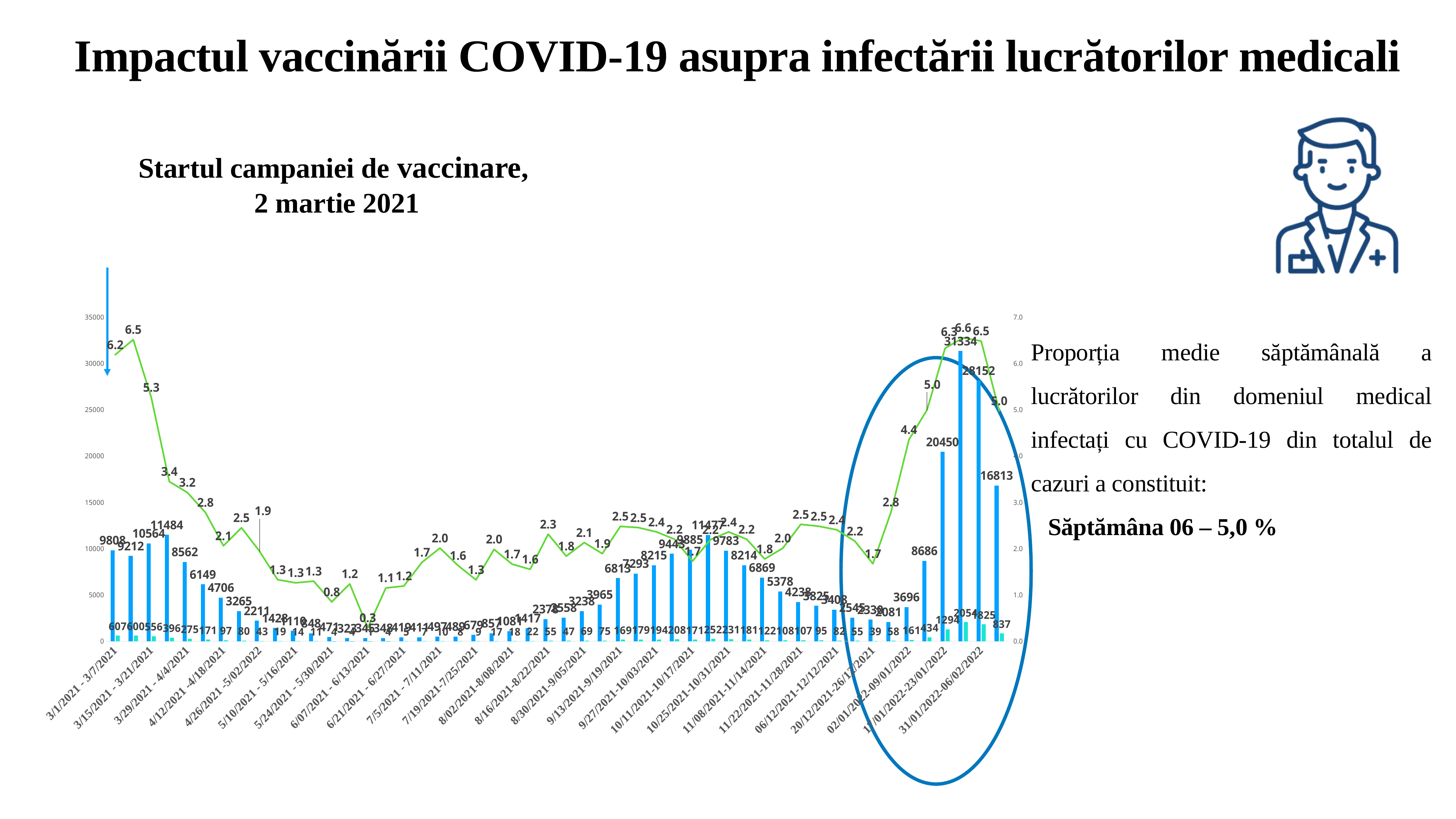
What is the difference between the two tallest blue bars, labelled 31334 and 28152? 3182 According to the slide, on what date did the vaccination campaign start? 2 martie 2021 What kind of chart is shown on the slide? A combined bar and line chart What is the value of the blue bar for the week 3/15/2021 - 3/21/2021? 10564 Which is larger: the blue bar labelled 20450 or the blue bar labelled 16813? 20450 What is the highest value labelled on the green line? 6.6 What is the highest value labelled on the blue bars? 31334 What is the value of the blue bar for the week 3/1/2021 - 3/7/2021? 9808 What is the lowest value labelled on the green line? 0.3 What is the title of the slide containing the chart? Impactul vaccinării COVID-19 asupra infectării lucrătorilor medicali What is the value of the green line at the first week, 3/1/2021 - 3/7/2021? 6.2 Does the green line rise or fall between the week 3/1/2021 - 3/7/2021 and the week 5/10/2021 - 5/16/2021? It falls